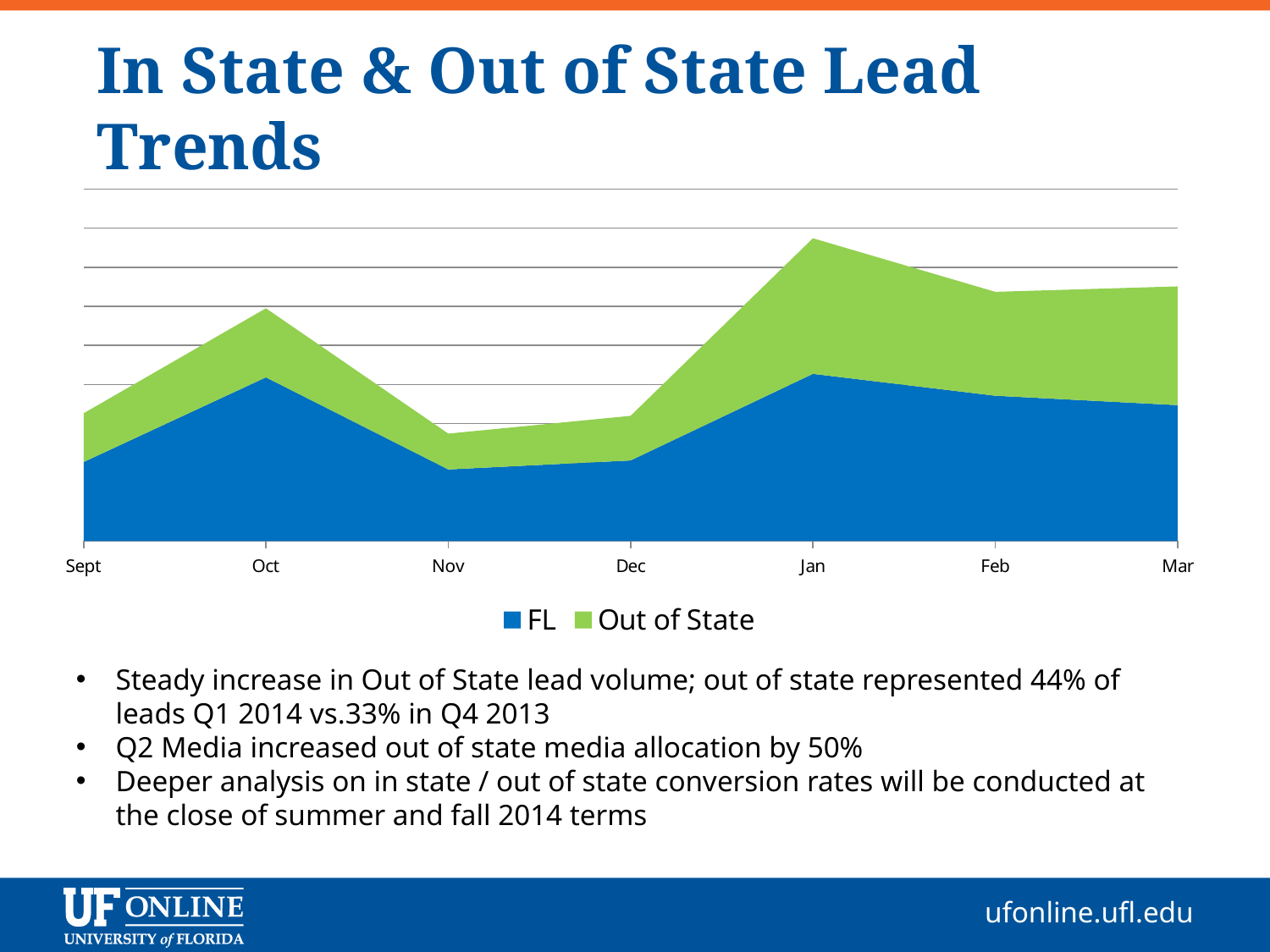
Does the total lead volume rise or fall from Dec to Jan? Rise In which month is the total lead volume (FL plus Out of State) highest? Jan Is the total lead volume larger in Jan or in Oct? Jan What is the title of the slide containing the chart? In State & Out of State Lead Trends How many months are plotted along the x axis of the chart? 7 Does the total lead volume rise or fall from Oct to Nov? Fall What kind of chart is shown on the slide? Stacked area chart Is the Out of State lead volume larger in Jan or in Sept? Jan Which month is the first category on the x axis? Sept Which series is shown in green in the chart? Out of State In which month is the total lead volume (FL plus Out of State) lowest? Nov How many series does the chart's legend list? 2